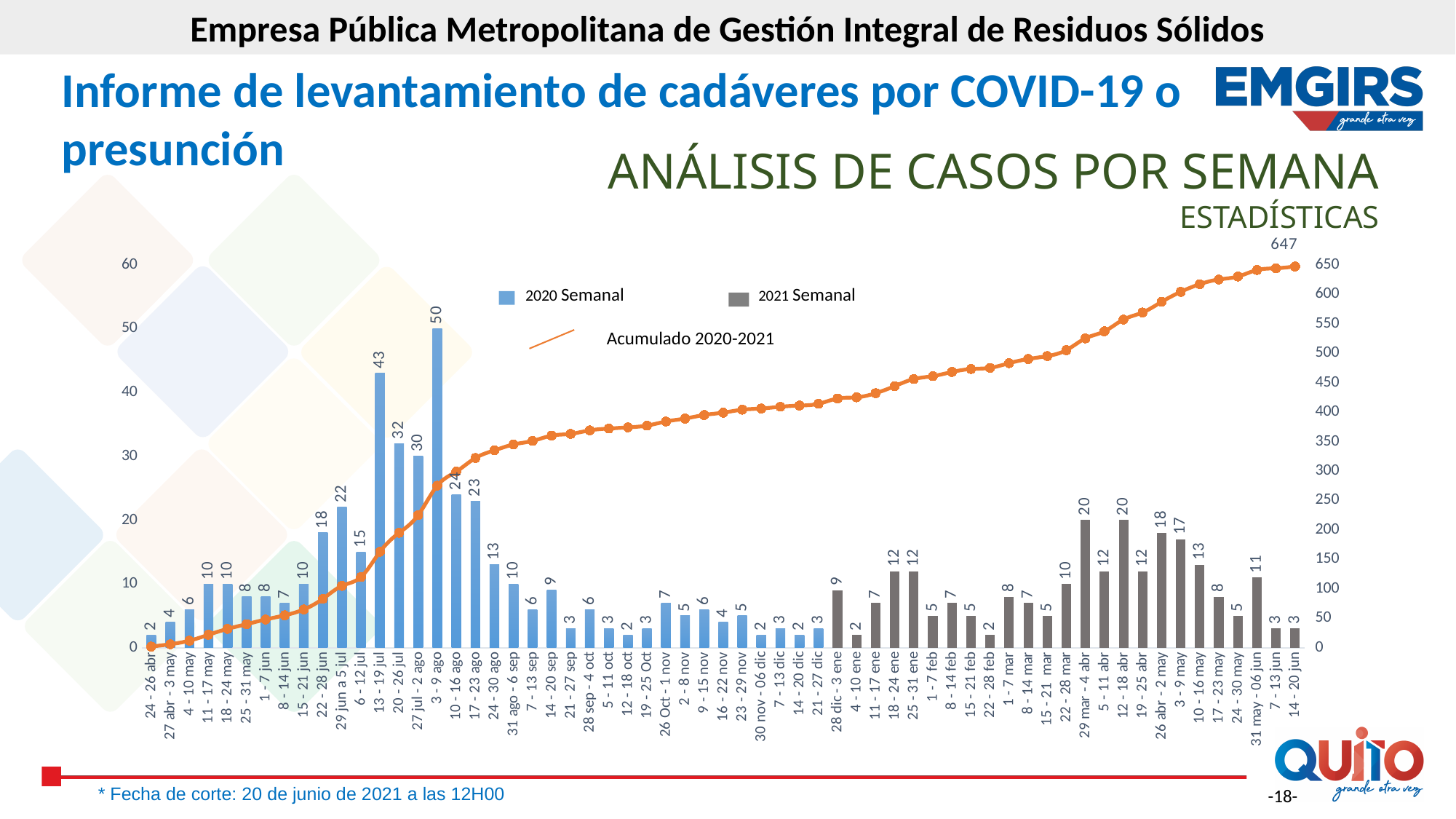
What is the highest weekly value reached by the 2021 Semanal series? 20 Which week has the highest weekly bar in the chart? 3 - 9 ago What is the final value shown on the Acumulado 2020-2021 line? 647 How many series does the legend list? 3 What is the value of the 2020 Semanal bar for 13 - 19 jul? 43 What is the value of the 2020 Semanal bar for the week 3 - 9 ago? 50 What is the 2021 Semanal value for the week 18 - 24 ene? 12 What is the difference between the weekly values for 3 - 9 ago and 13 - 19 jul? 7 What kind of chart is shown on the slide? Bar and line chart Does the Acumulado 2020-2021 line rise or fall along the x axis? Rises Which week has the larger 2021 Semanal value, 29 mar - 4 abr or 26 abr - 2 may? 29 mar - 4 abr What colour represents the 2021 Semanal series in the legend? Gray